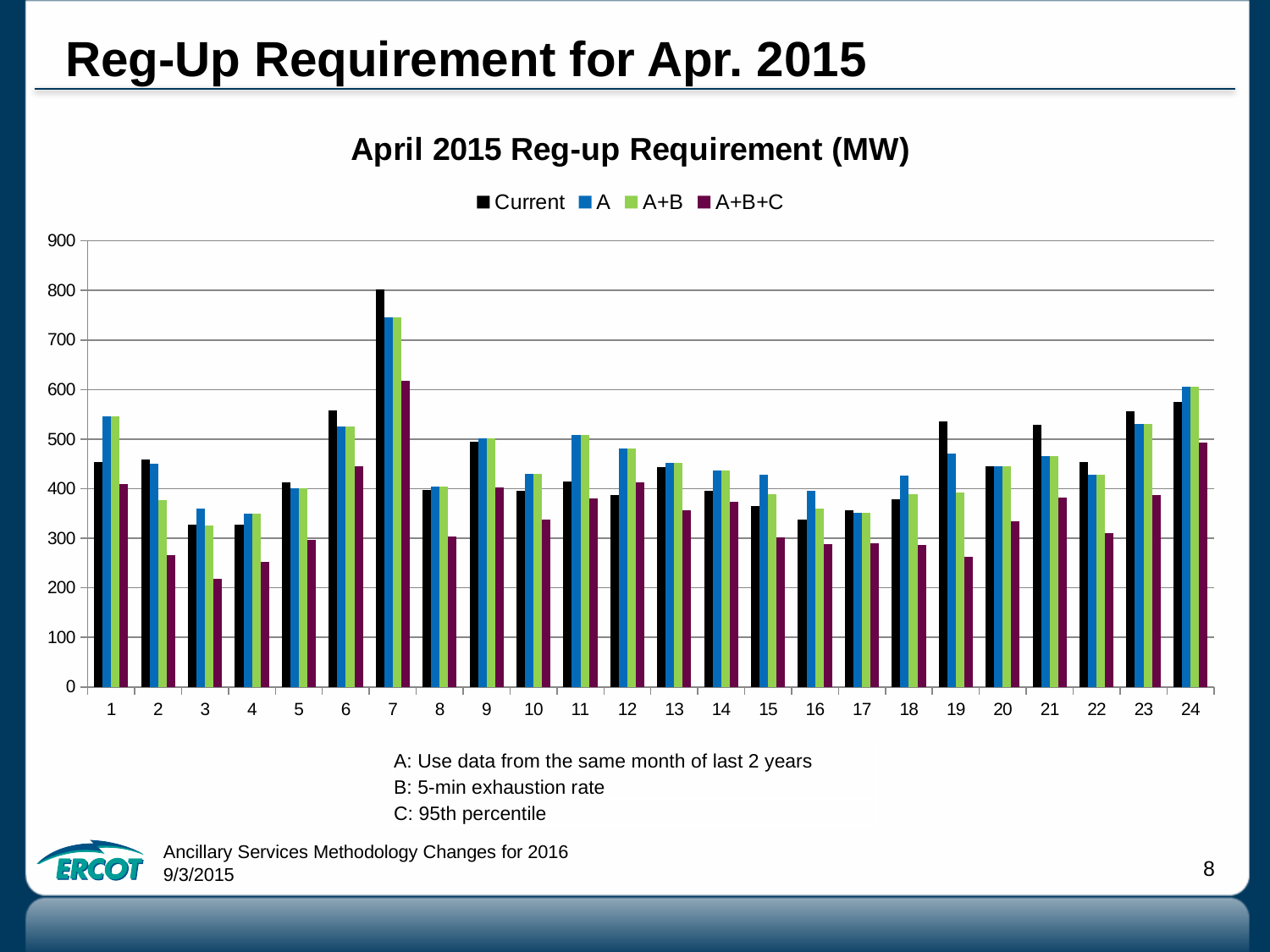
At which hour is the Current series highest? 7 Is the A value at hour 24 greater or less than 500? greater Is the Current value at hour 7 greater or less than 700? greater What type of chart is shown on the slide? bar chart At which hour is the A series highest? 7 How many series does the legend list? 4 At which hour is the A+B+C series lowest? 3 What is the title of the chart? April 2015 Reg-up Requirement (MW) How many hours (categories) are plotted along the x axis? 24 Which is larger: the Current value at hour 7 or the Current value at hour 24? hour 7 Which is larger: the A+B+C value at hour 7 or the A+B+C value at hour 16? hour 7 Is the A+B+C value at hour 3 greater or less than 300? less